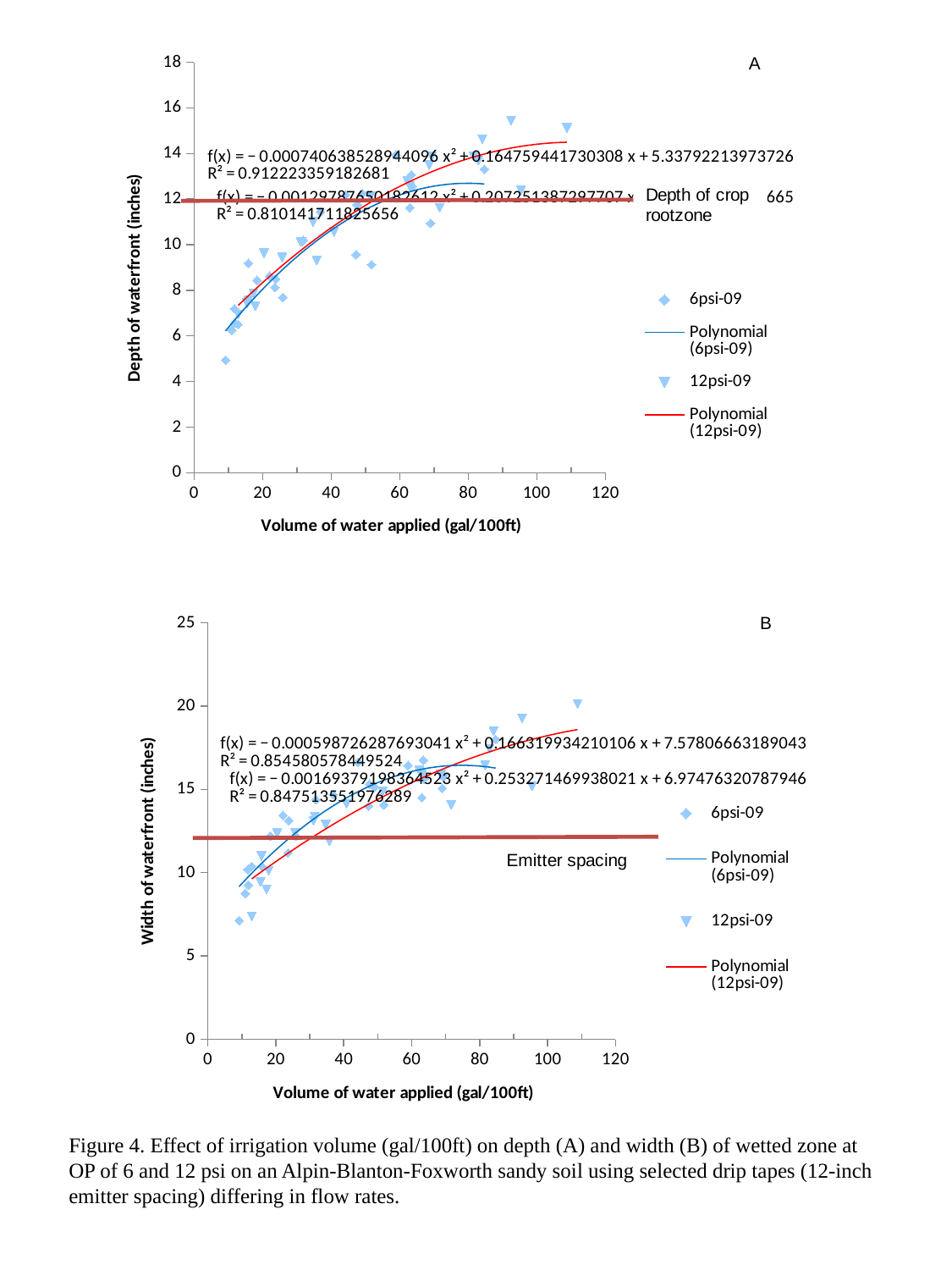
In chart A, what does the horizontal red line at 12 inches represent? Depth of crop rootzone In chart A, what is the R² value printed for the first (upper) polynomial equation? 0.912223359182681 In chart B, how many entries does the legend list? 4 In chart B, what is the R² value printed for the second (lower) polynomial equation? 0.847513551976289 In chart A, how many entries does the legend list? 4 In chart A, is the highest 12psi-09 point greater or less than 14 inches? greater In chart B, what is the R² value printed for the first (upper) polynomial equation? 0.854580578449524 In chart B, do the width of waterfront values generally rise or fall as the volume of water applied increases? Rise What is the y-axis title of chart B? Width of waterfront (inches) In chart B, is the highest 12psi-09 point greater or less than 15 inches? greater In chart A, do the depth of waterfront values generally rise or fall as the volume of water applied increases? Rise What kind of chart is chart A? Scatter chart